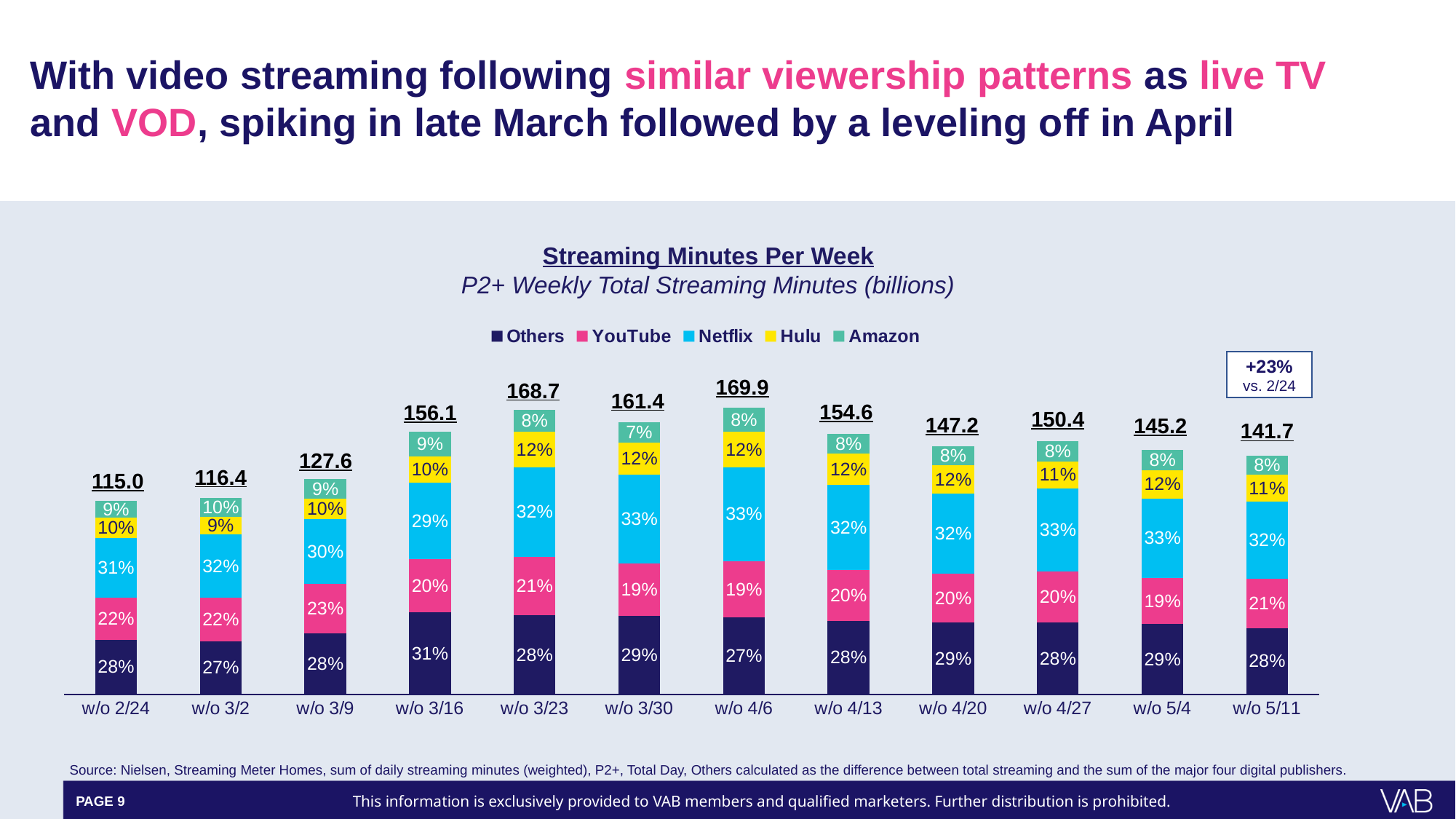
How many weeks are shown along the x axis of the chart? 12 What percentage change versus w/o 2/24 is annotated above the w/o 5/11 bar? +23% What is the difference in total streaming minutes between w/o 4/6 and w/o 2/24? 54.9 How many series does the chart's legend list? 5 Which week has a larger total of streaming minutes, w/o 3/9 or w/o 3/16? w/o 3/16 What kind of chart is shown on the slide? Stacked bar chart Which week has the highest total streaming minutes? w/o 4/6 What share of streaming minutes did Amazon account for in w/o 3/30? 7% What share of streaming minutes did Netflix account for in w/o 3/23? 32% What share of streaming minutes did Hulu account for in w/o 5/11? 11% What is the total streaming minutes (billions) for w/o 3/23? 168.7 Which week has the lowest total streaming minutes? w/o 2/24